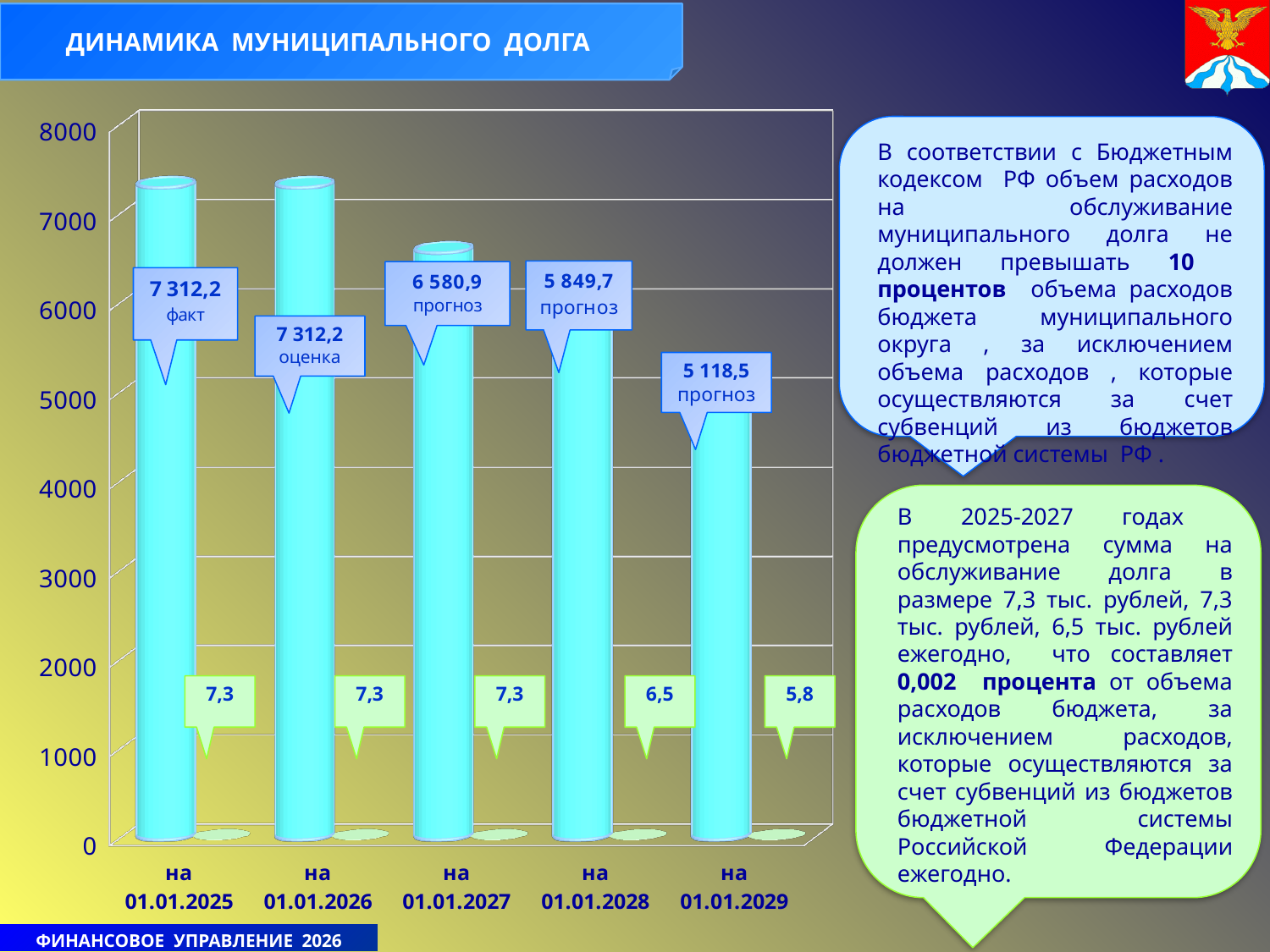
How many dates (bars) are shown on the chart? 5 What is the value shown for на 01.01.2027? 6 580,9 What kind of chart is shown on the slide? bar chart What is the value shown for на 01.01.2028? 5 849,7 What is the value shown for на 01.01.2029? 5 118,5 Is the value for на 01.01.2029 greater or less than 6000? less What is the difference between the values for на 01.01.2025 and на 01.01.2029? 2 193,7 Which date has the lowest municipal debt value? на 01.01.2029 What is the difference between the values for на 01.01.2026 and на 01.01.2027? 731,3 What is the municipal debt value shown for на 01.01.2025? 7 312,2 Which is larger, the value for на 01.01.2027 or the value for на 01.01.2028? на 01.01.2027 Do the municipal debt values rise or fall from на 01.01.2026 to на 01.01.2029? fall